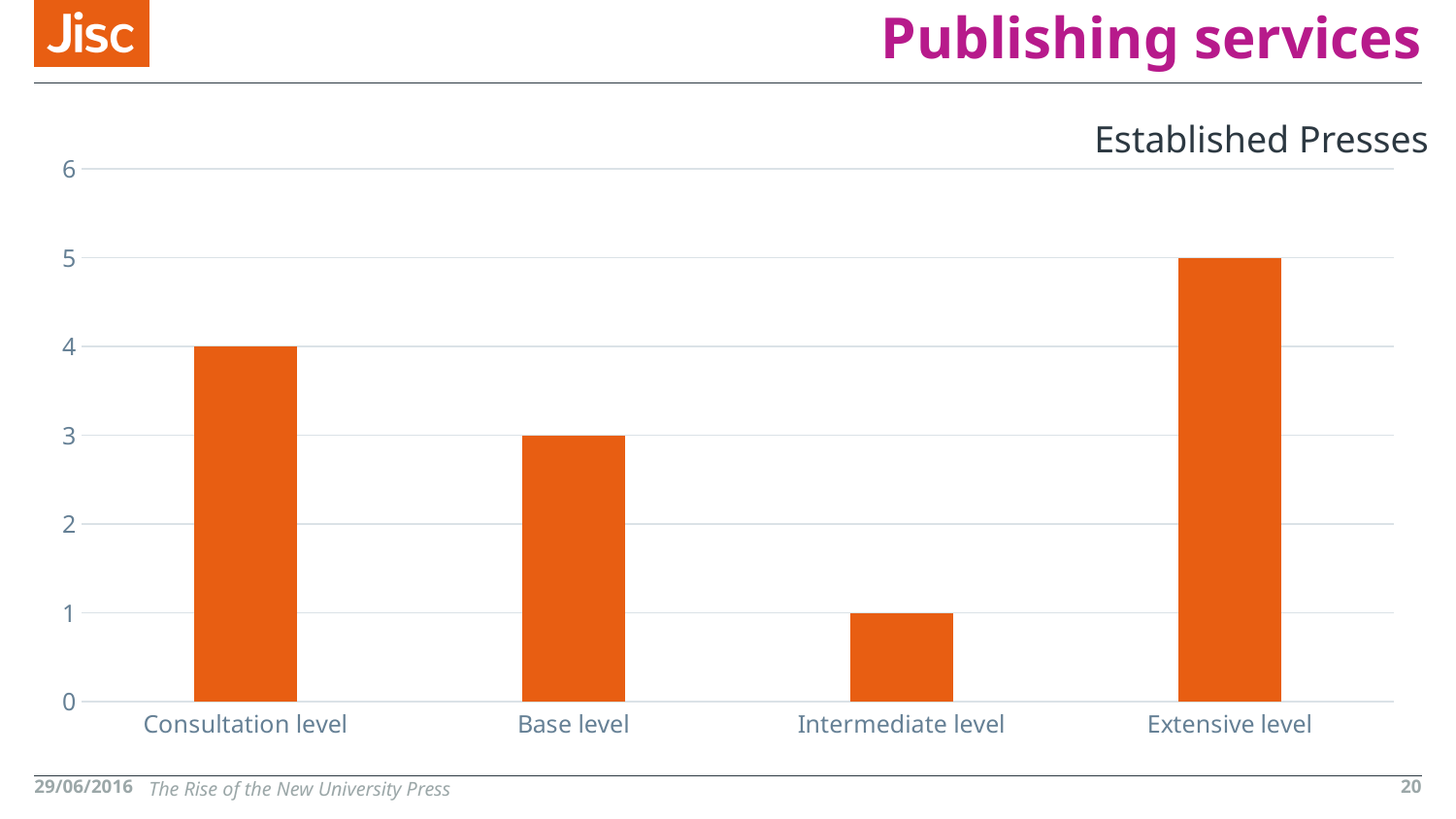
What is the value for Consultation level? 4 Which is larger, the value for Consultation level or the value for Base level? Consultation level What is the value for Extensive level? 5 Which category has the highest value? Extensive level What kind of chart is shown on the slide? Bar chart What is the difference between the values for Extensive level and Intermediate level? 4 What is the value for Base level? 3 Is the value for Extensive level greater or less than 4? greater How many categories are shown on the x axis? 4 What is the value for Intermediate level? 1 Which category has the lowest value? Intermediate level What is the title of the chart? Established Presses